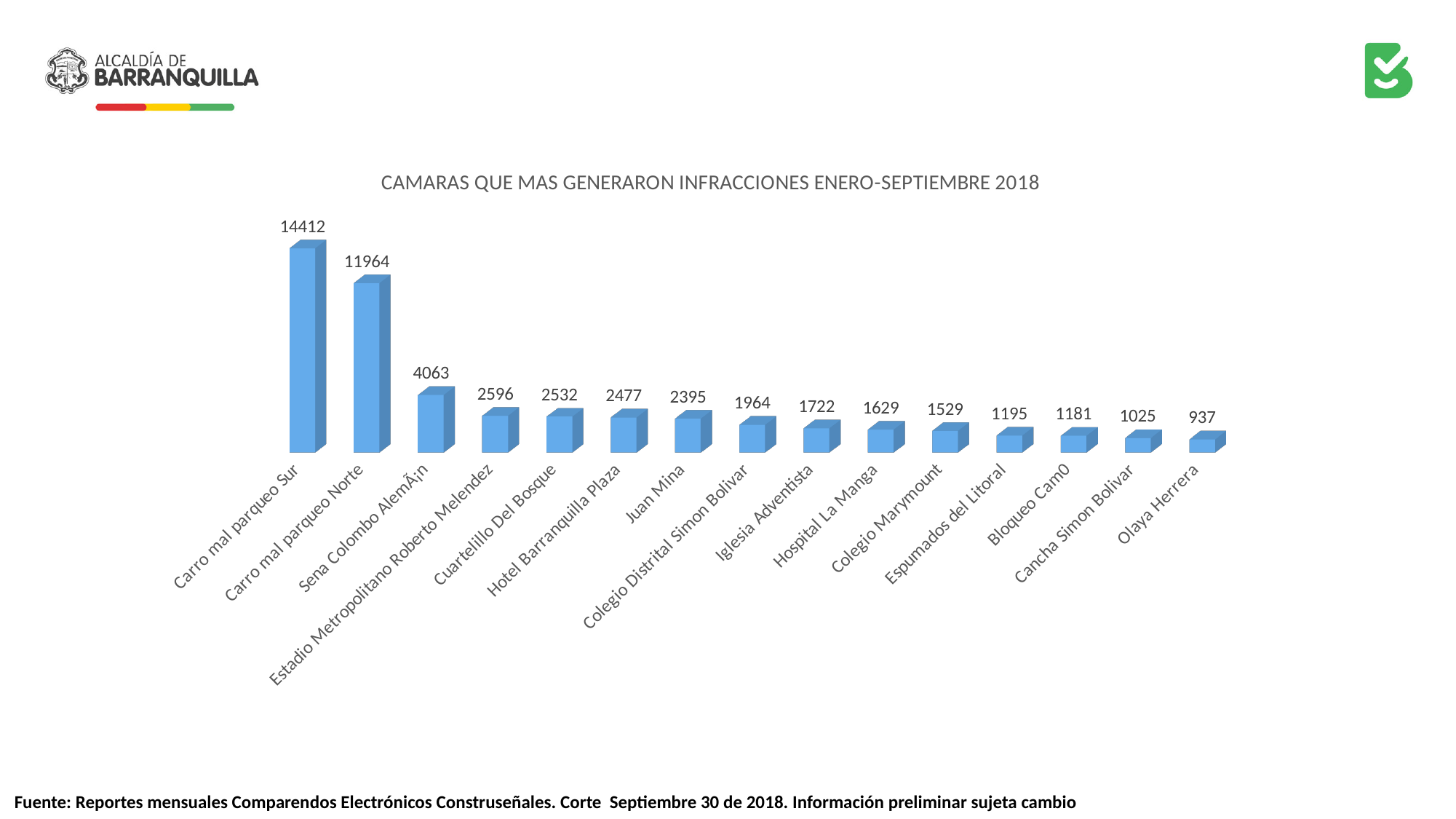
What is the value for Juan Mina? 2395 What is the difference between Sena Colombo Alemán and Estadio Metropolitano Roberto Melendez? 1467 What is the difference between Carro mal parqueo Sur and Carro mal parqueo Norte? 2448 What kind of chart is shown? Bar chart How many cameras are shown in the chart? 15 What is the value for Cancha Simon Bolivar? 1025 Which camera has the lowest value? Olaya Herrera What is the value for Hospital La Manga? 1629 Which camera has the highest value? Carro mal parqueo Sur Do the values rise or fall from left to right along the x axis? Fall What is the value for Carro mal parqueo Sur? 14412 Which is larger, Colegio Distrital Simon Bolivar or Iglesia Adventista? Colegio Distrital Simon Bolivar